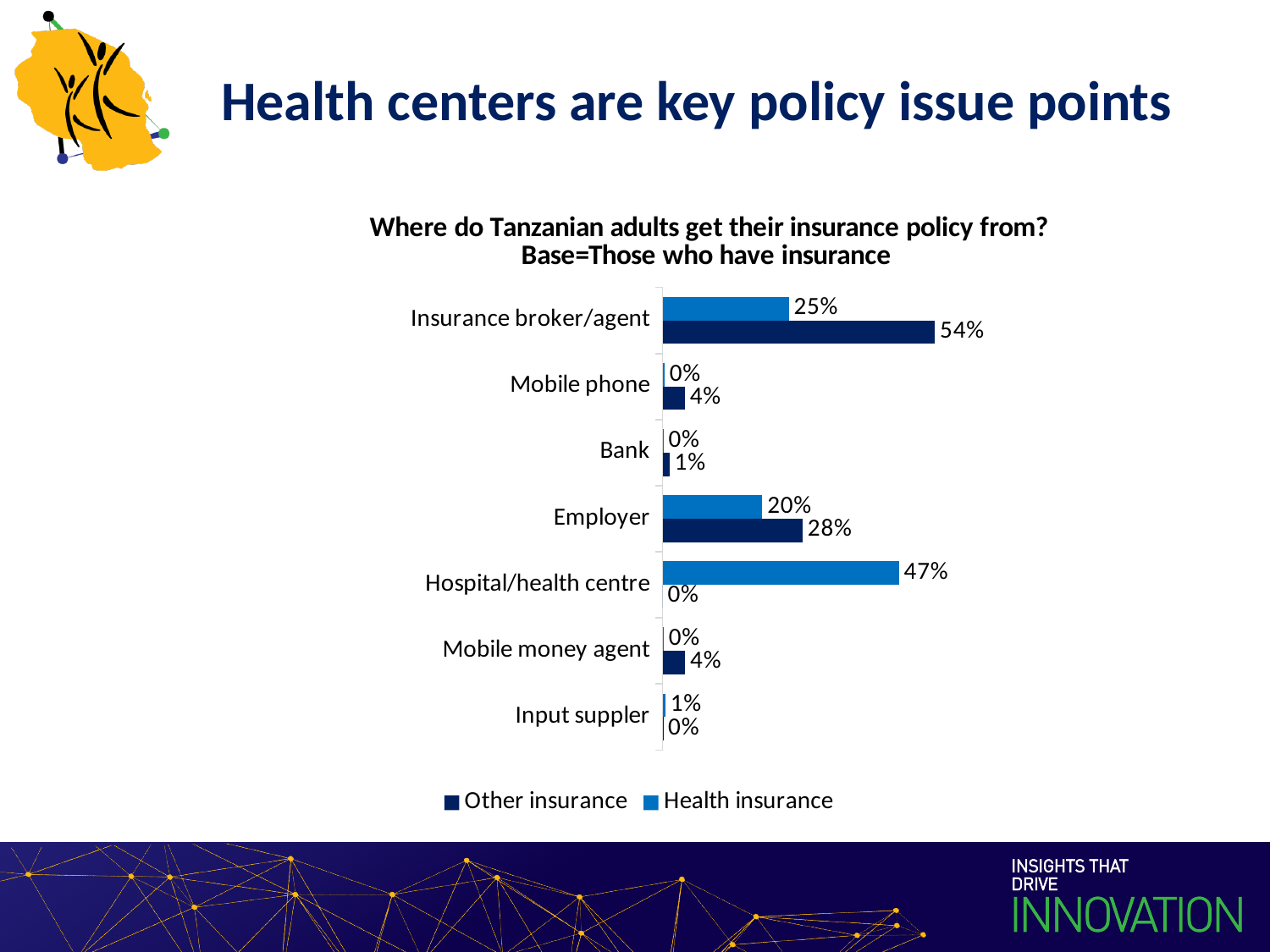
Which source has the highest value for Other insurance? Insurance broker/agent How many sources (categories) are shown on the chart? 7 What is the difference between the Other insurance and Health insurance values for Insurance broker/agent? 29% What is the Other insurance value for Bank? 1% For Employer, which is larger: the Other insurance value or the Health insurance value? Other insurance What percentage of Tanzanian adults with health insurance get their policy from a hospital/health centre? 47% What is the value for Other insurance for Insurance broker/agent? 54% Which source has the highest value for Health insurance? Hospital/health centre Which series is shown in light blue in the legend? Health insurance What is the Health insurance value for Employer? 20% What type of chart is shown on the slide? Bar chart How many series does the legend list? 2